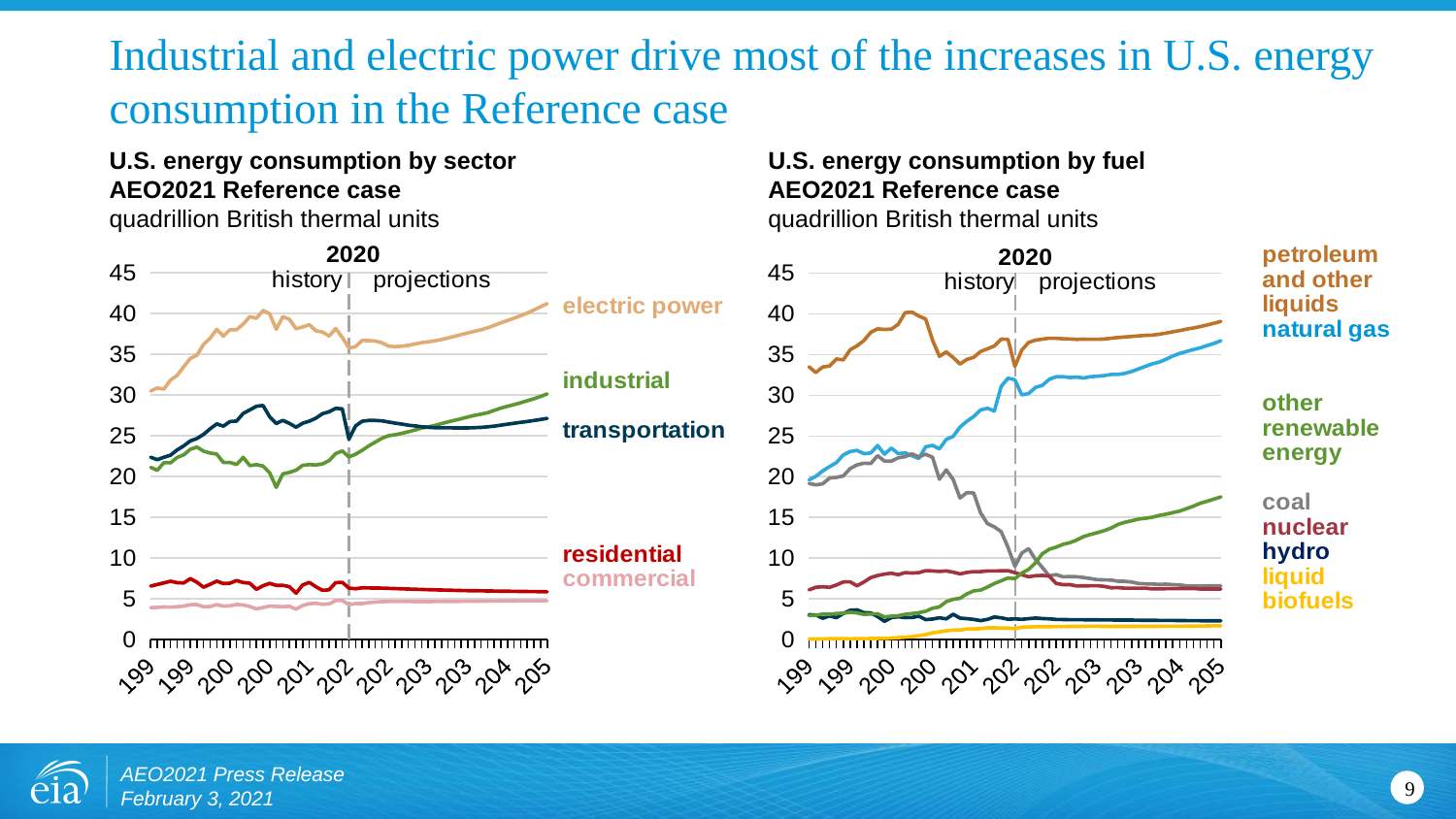
How many series are labelled on the 'U.S. energy consumption by sector' chart? 5 How many series are labelled on the 'U.S. energy consumption by fuel' chart? 7 In the 'U.S. energy consumption by fuel' chart, is the value for other renewable energy at the end of the projection period greater or less than 15? greater In the 'U.S. energy consumption by fuel' chart, does other renewable energy rise or fall over the projection period? rise In the 'U.S. energy consumption by sector' chart, is the value for electric power at the end of the projection period greater or less than 40? greater What year does the dashed vertical line separating history from projections mark on both charts? 2020 In the 'U.S. energy consumption by sector' chart, which sector has the highest consumption at the end of the projection period? electric power What type of chart is the 'U.S. energy consumption by sector' chart on the left? line chart What type of chart is the 'U.S. energy consumption by fuel' chart on the right? line chart In the 'U.S. energy consumption by fuel' chart, which fuel has the highest consumption at the end of the projection period? petroleum and other liquids In the 'U.S. energy consumption by fuel' chart, is the value for hydro at the end of the projection period greater or less than 5? less In the 'U.S. energy consumption by fuel' chart, which is larger at the end of the projection period, natural gas or coal? natural gas